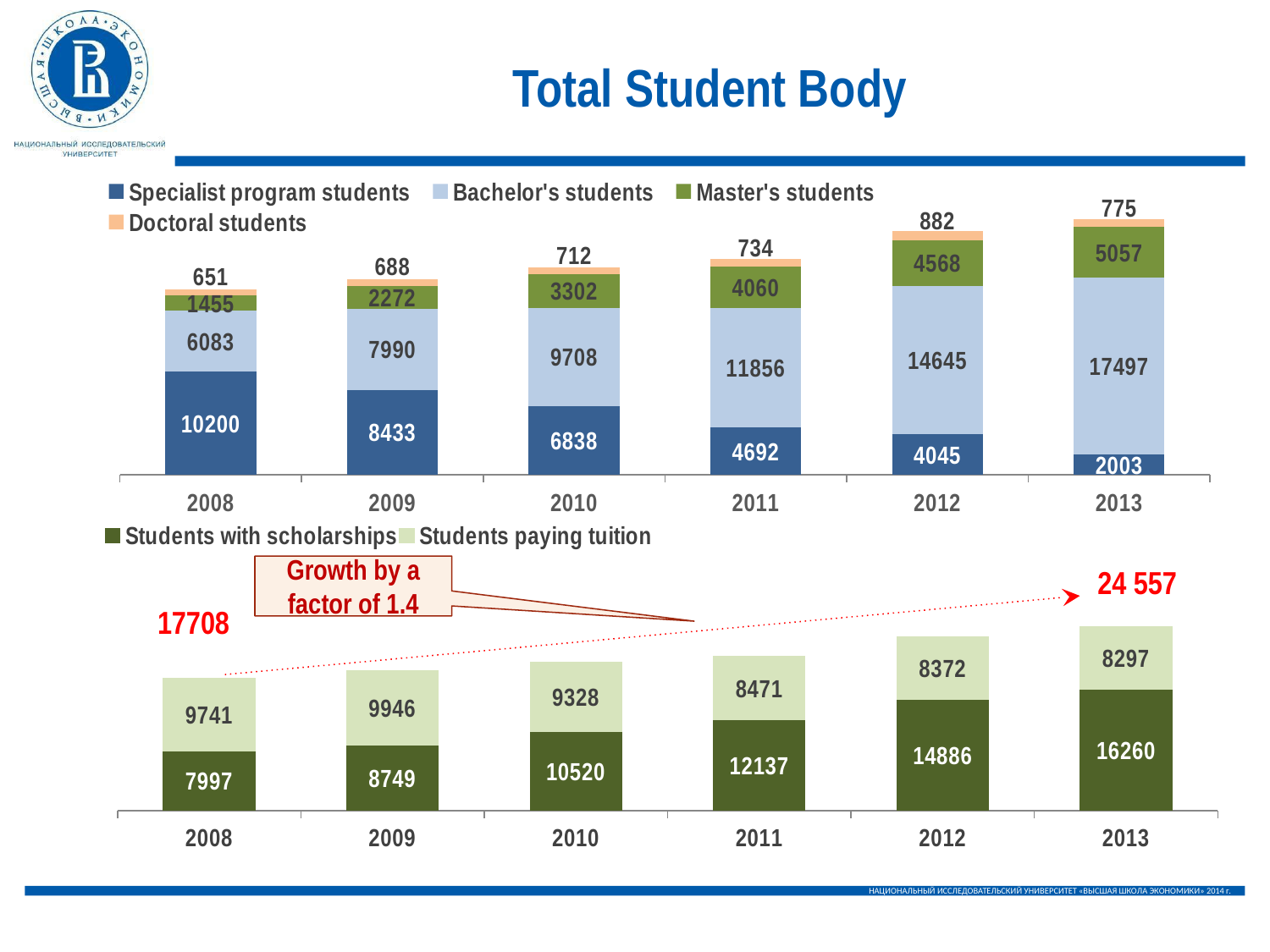
In the top chart, in 2011, which is larger: Bachelor's students or Specialist program students? Bachelor's students What kind of chart is the bottom chart? bar chart How many series does the legend of the top chart list? 4 In the top chart, which year has the lowest number of Specialist program students? 2013 In the bottom chart, what is the total of the stacked bar for 2013? 24 557 In the top chart, which year has the highest number of Master's students? 2013 In the top chart, what is the value for Specialist program students in 2008? 10200 In the top chart, do the values for Specialist program students rise or fall from 2008 to 2013? fall In the top chart, how many Bachelor's students were there in 2013? 17497 In the bottom chart, what is the difference between students with scholarships and students paying tuition in 2010? 1192 In the bottom chart, how many students with scholarships were there in 2012? 14886 In the top chart, by how much did the number of Bachelor's students increase from 2008 to 2013? 11414